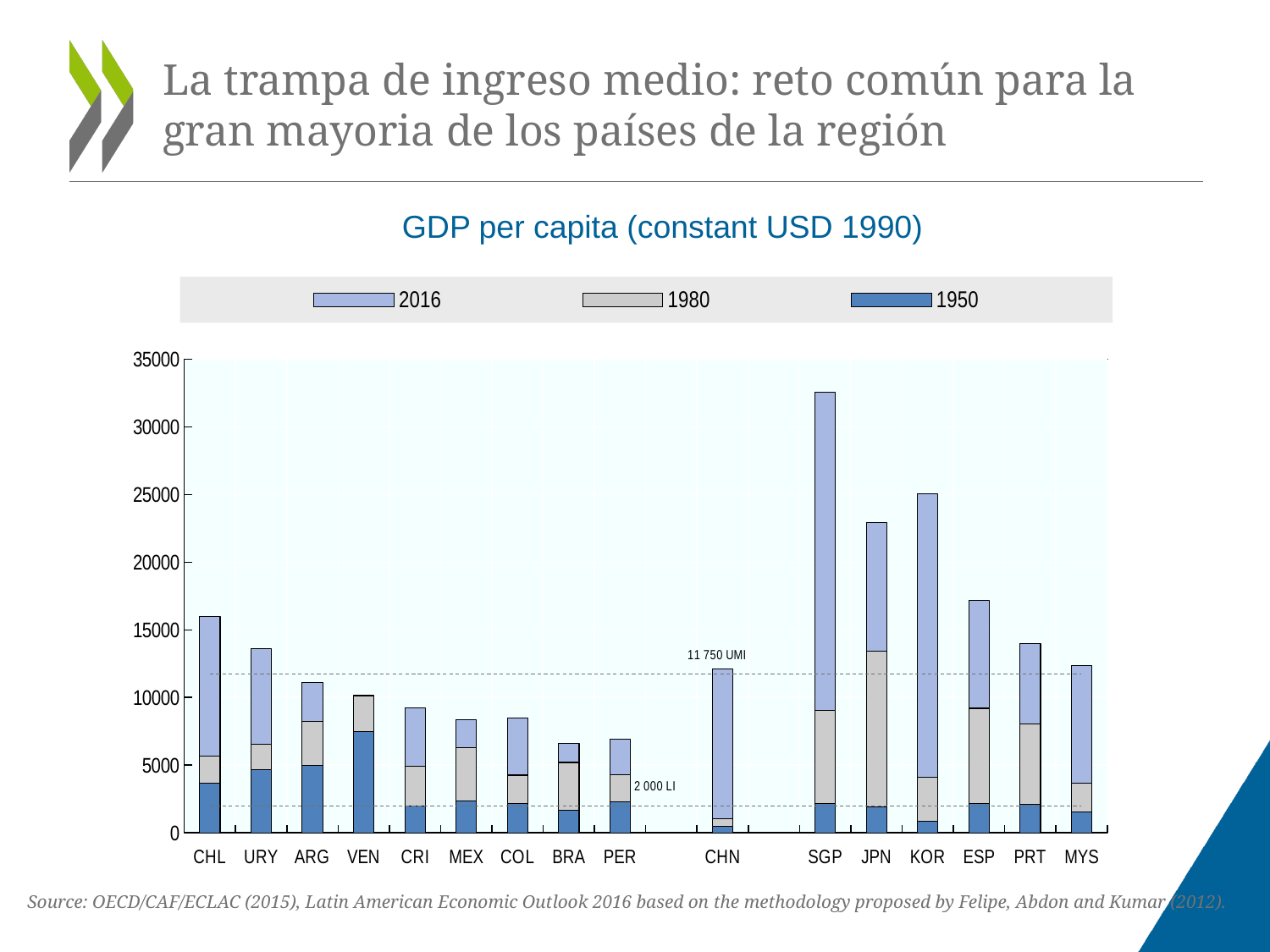
Which has the larger 2016 GDP per capita, SGP or JPN? SGP Which country has the highest 2016 GDP per capita in the chart? SGP Is the 2016 value for VEN greater or less than 15000? less Is the 2016 value for KOR greater or less than 20000? greater What kind of chart is shown on the slide? bar chart Which country has the lowest 2016 GDP per capita in the chart? BRA How many countries are shown on the x axis of the chart? 16 Which has the larger 2016 GDP per capita, CHL or URY? CHL Which years are listed in the chart legend? 2016, 1980, 1950 How many series does the legend list? 3 What is the title of the chart? GDP per capita (constant USD 1990) Is the 2016 value for SGP greater or less than 30000? greater